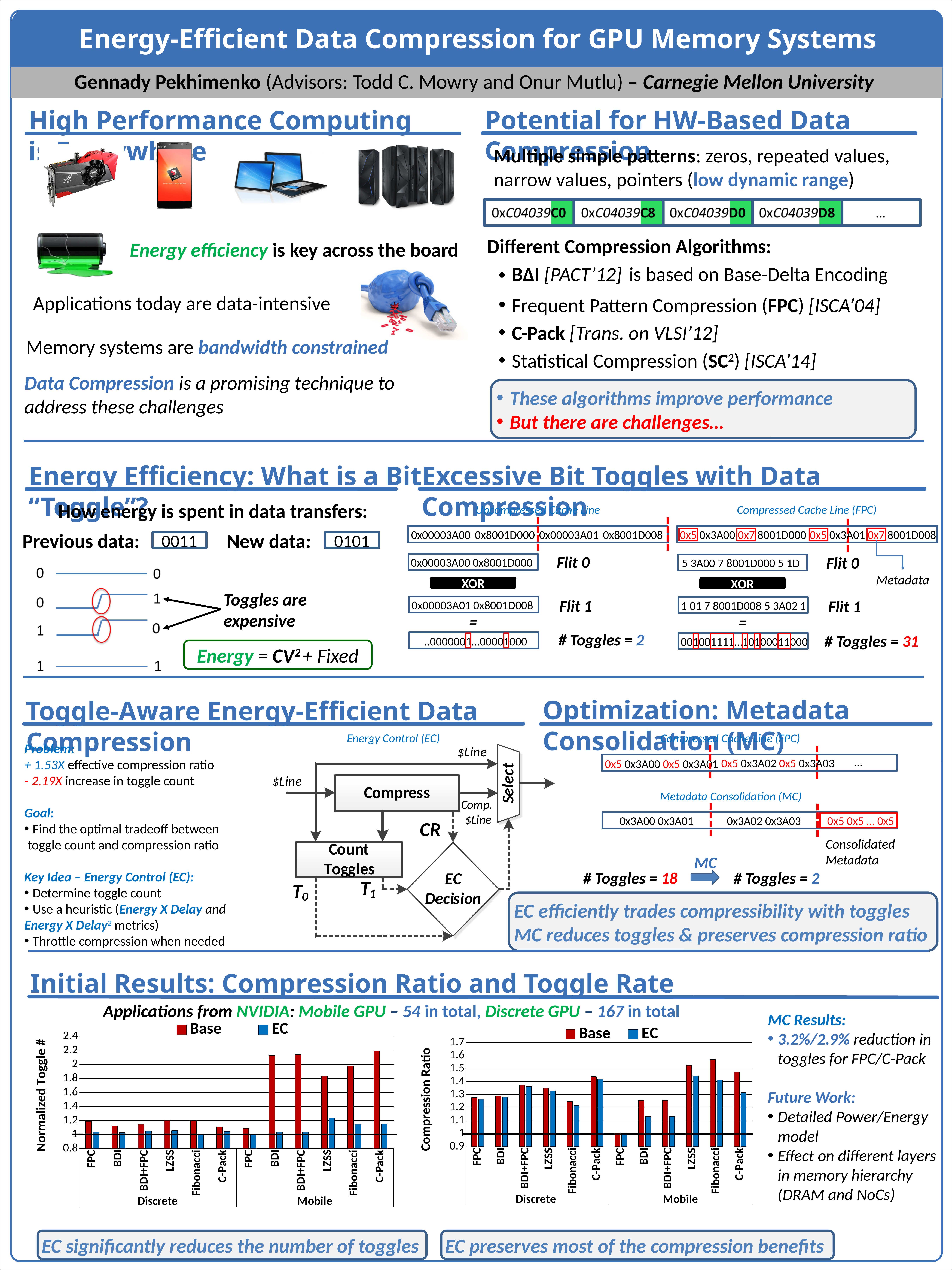
In the left chart (Normalized Toggle #), is the Base value for BDI in the Mobile group greater or less than 2? greater What colour represents the EC series in the left chart (Normalized Toggle #)? blue In the right chart (Compression Ratio), is the Base value for BDI+FPC in the Discrete group greater or less than 1.3? greater How many series does the legend of the right chart (Compression Ratio) list? 2 What is the y-axis title of the right chart? Compression Ratio In the left chart (Normalized Toggle #), is the Base value for FPC in the Discrete group greater or less than 1? greater In the left chart (Normalized Toggle #), which is larger: the Base value for BDI in the Mobile group or the Base value for BDI in the Discrete group? BDI in the Mobile group In the right chart (Compression Ratio), which is larger: the Base value for LZSS in the Mobile group or the Base value for LZSS in the Discrete group? LZSS in the Mobile group In the right chart (Compression Ratio), which category has the lowest Base value? FPC (Mobile) What kind of chart is the left chart (Normalized Toggle #)? bar chart How many bar groups (categories) are plotted along the x axis of the left chart (Normalized Toggle #)? 12